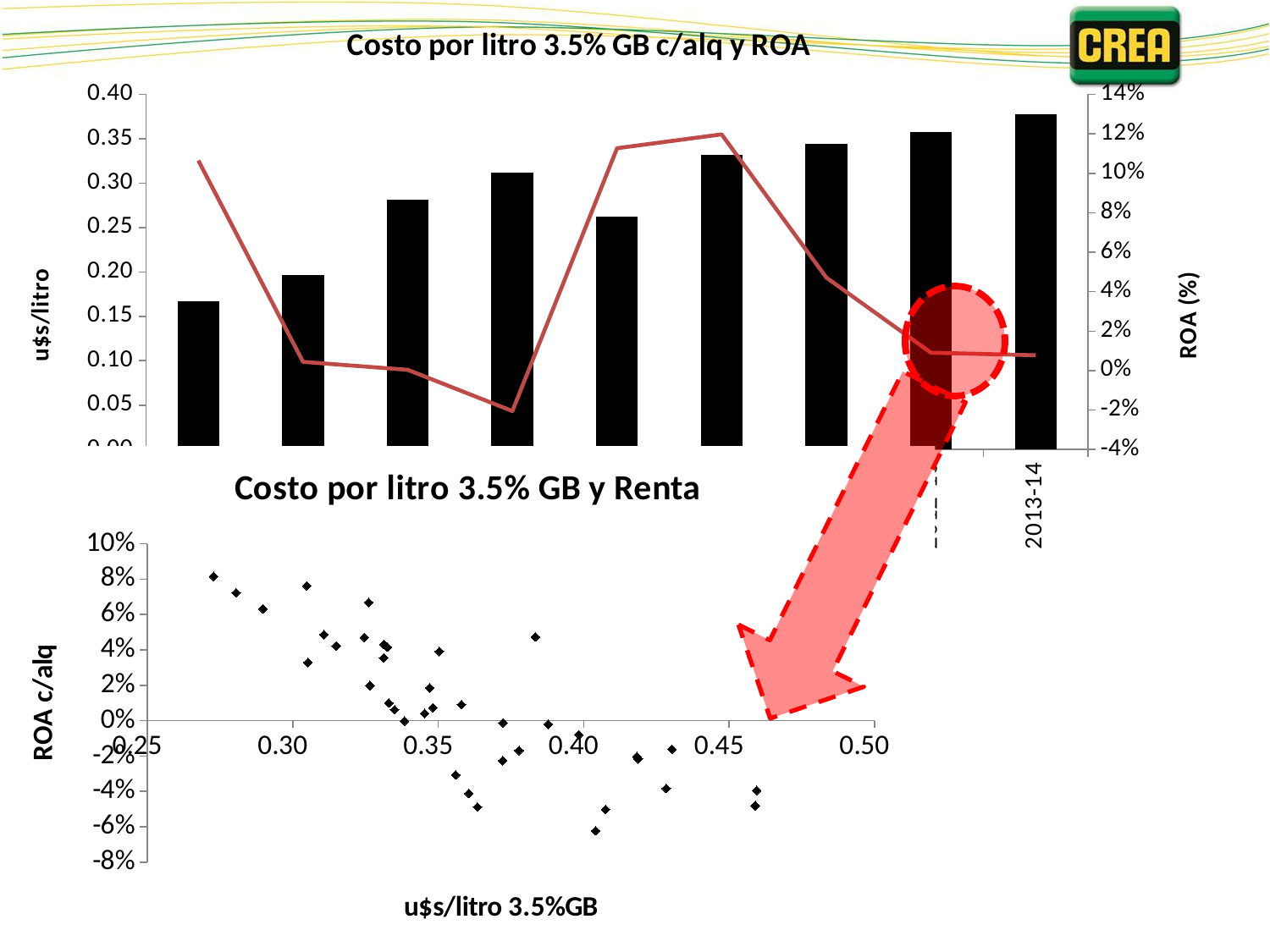
In the top chart 'Costo por litro 3.5% GB c/alq y ROA', which period has the tallest bar? 2013-14 In the top chart 'Costo por litro 3.5% GB c/alq y ROA', do the bar values generally rise or fall from left to right? rise In the top chart 'Costo por litro 3.5% GB c/alq y ROA', what is the title of the left vertical axis? u$s/litro In the bottom chart 'Costo por litro 3.5% GB y Renta', what is the title of the horizontal axis? u$s/litro 3.5%GB In the top chart 'Costo por litro 3.5% GB c/alq y ROA', is the bar value for 2013-14 greater or less than 0.35? greater In the bottom chart 'Costo por litro 3.5% GB y Renta', what is the title of the vertical axis? ROA c/alq In the top chart 'Costo por litro 3.5% GB c/alq y ROA', is the ROA line value for 2013-14 greater or less than 2%? less In the top chart 'Costo por litro 3.5% GB c/alq y ROA', how many bars are plotted? 9 In the bottom chart 'Costo por litro 3.5% GB y Renta', does ROA c/alq tend to rise or fall as u$s/litro 3.5%GB increases? fall In the bottom chart 'Costo por litro 3.5% GB y Renta', what kind of chart is it? scatter chart In the top chart 'Costo por litro 3.5% GB c/alq y ROA', what kind of chart is it? bar chart with a line